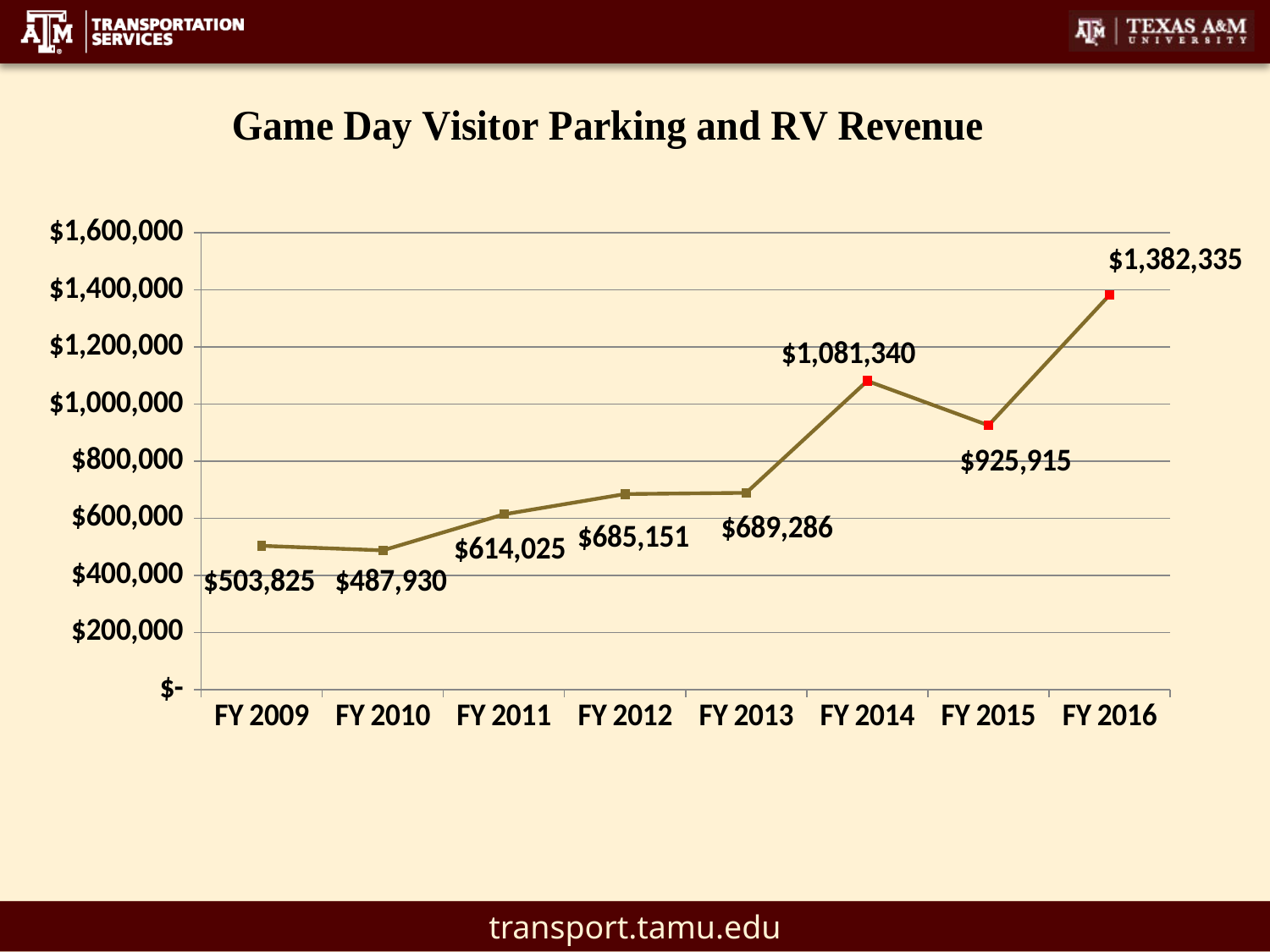
What is the revenue for FY 2010? $487,930 Is the value for FY 2015 greater or less than $800,000? greater What is the difference in revenue between FY 2016 and FY 2015? $456,420 What kind of chart is shown on the slide? line chart How many fiscal years are plotted on the chart? 8 What is the revenue for FY 2014? $1,081,340 What is the difference in revenue between FY 2014 and FY 2013? $392,054 What is the revenue for FY 2016? $1,382,335 Which has the larger revenue, FY 2014 or FY 2015? FY 2014 What is the title of the chart? Game Day Visitor Parking and RV Revenue Which fiscal year has the lowest revenue? FY 2010 Which fiscal year has the highest revenue? FY 2016